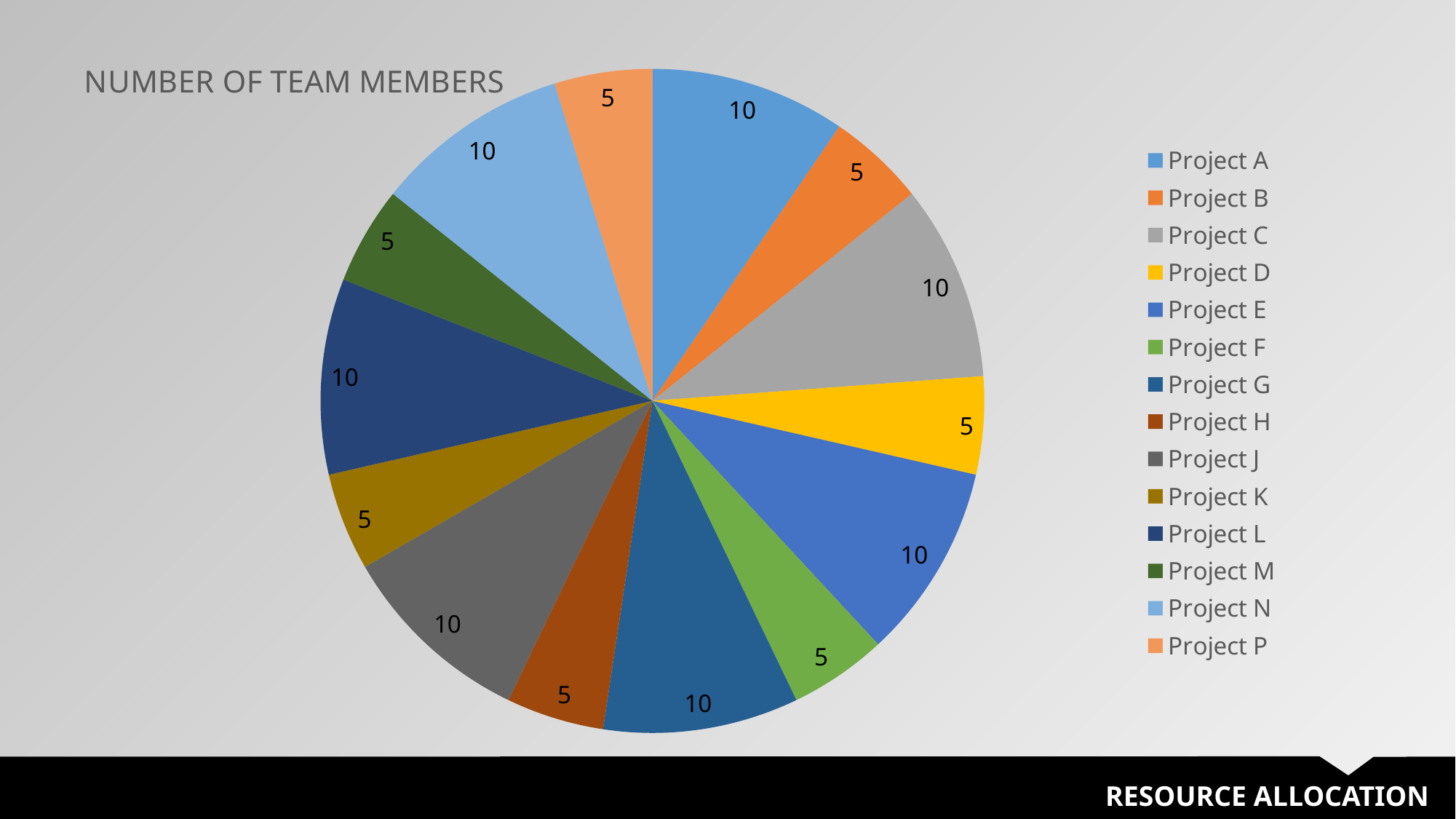
How many team members are allocated to Project A? 10 How many team members are allocated to Project L? 10 What is the difference in team members between Project C and Project B? 5 How many team members are allocated to Project P? 5 What is the title of the chart? NUMBER OF TEAM MEMBERS How many team members are allocated to Project H? 5 How many projects (slices) does the pie chart show? 14 What kind of chart is shown on the slide? pie chart How many team members are allocated to Project D? 5 What colour is the slice for Project D? yellow Which has more team members, Project E or Project F? Project E What is the total number of team members across all projects in the pie chart? 105